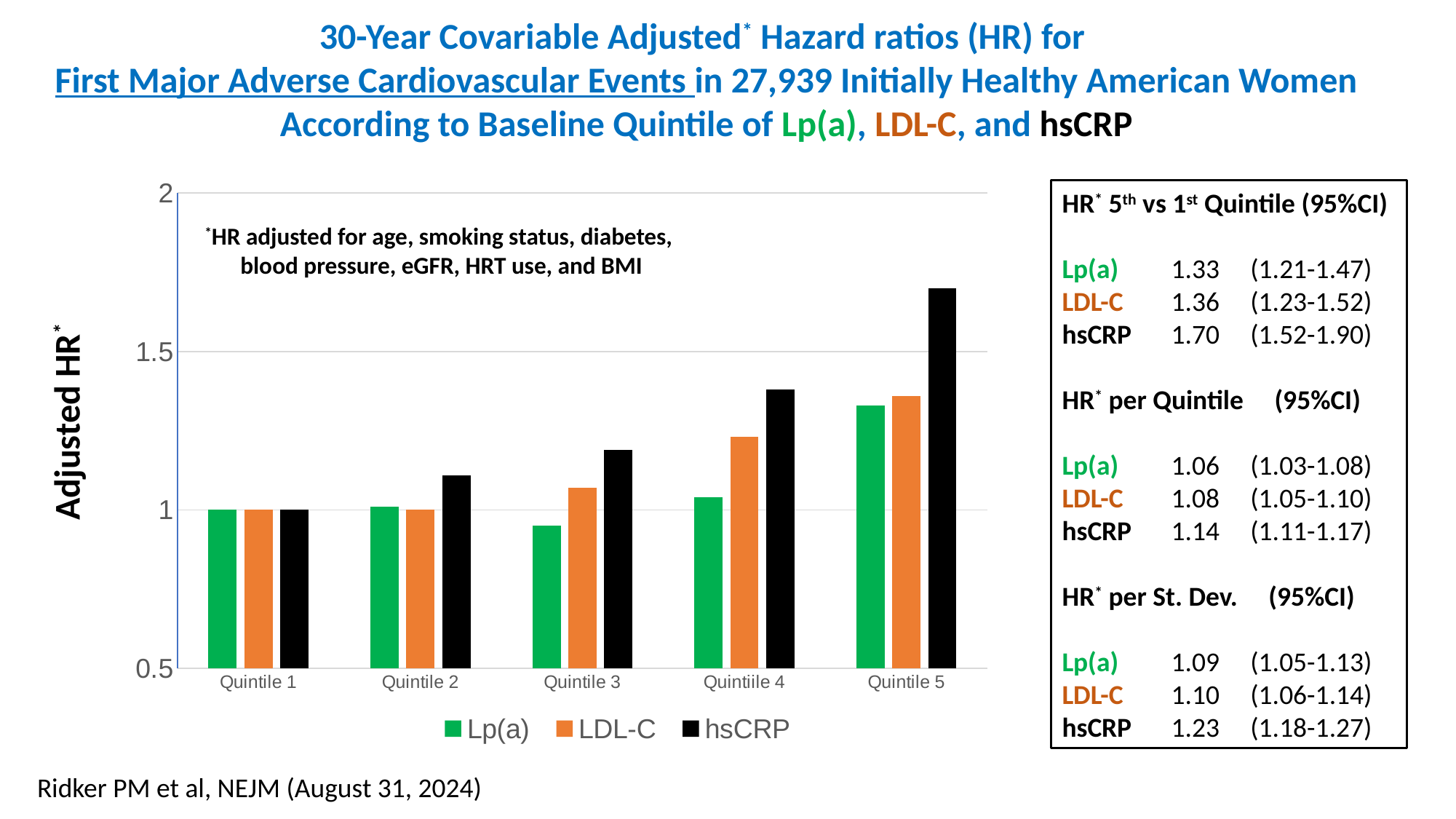
Does the adjusted HR for hsCRP rise or fall from Quintile 1 to Quintile 5? rise What is the label of the y axis of the chart? Adjusted HR* How many series does the chart legend list? 3 Which series has the highest adjusted HR in Quintile 5? hsCRP Is the adjusted HR for Lp(a) in Quintile 5 greater or less than 1.5? less Is the adjusted HR for hsCRP in Quintile 5 greater or less than 1.5? greater What kind of chart is shown on the slide? bar chart What is the adjusted HR for hsCRP in Quintile 1? 1 In Quintile 4, which is larger: the adjusted HR for LDL-C or for Lp(a)? LDL-C How many quintile categories are shown on the x axis of the chart? 5 Which series has the lowest adjusted HR in Quintile 3? Lp(a) Is the adjusted HR for LDL-C in Quintile 4 greater or less than 1? greater